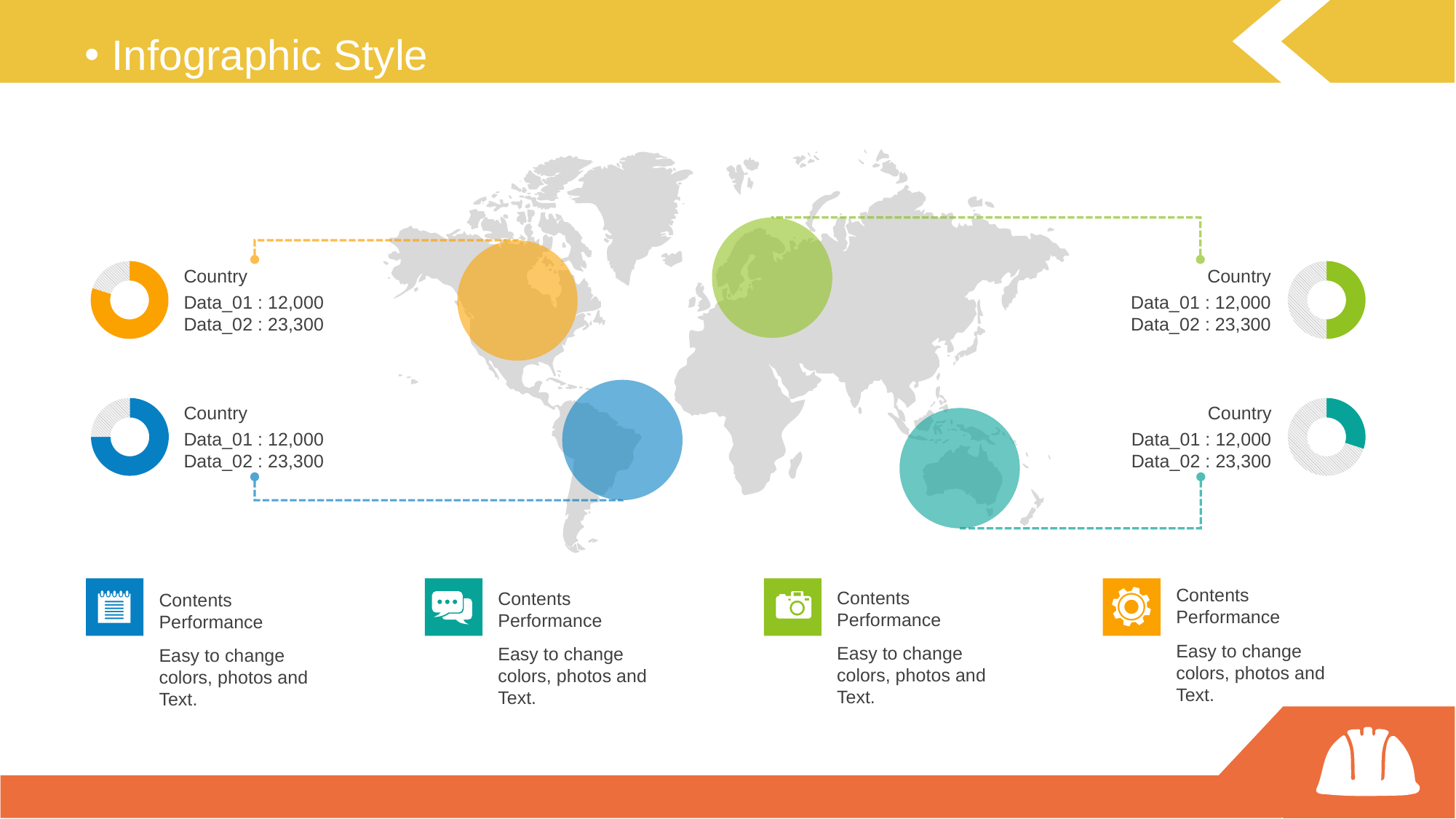
How many doughnut charts are on the slide? 4 For the top-left (orange) doughnut chart, what is the value of Data_02? 23,300 For the top-right (green) doughnut chart, what is the value of Data_01? 12,000 For the bottom-left (blue) doughnut chart, what is the difference between Data_02 and Data_01? 11,300 For the bottom-left (blue) doughnut chart, what is the value of Data_02? 23,300 For the top-left (orange) doughnut chart, what is the value of Data_01? 12,000 For the top-left (orange) doughnut chart, what is the difference between Data_02 and Data_01? 11,300 What kind of chart is shown next to each 'Country' label on the slide? doughnut chart For the bottom-right (teal) doughnut chart, which is larger, Data_01 or Data_02? Data_02 What colour is the doughnut chart in the bottom-left position of the slide? blue What colour is the doughnut chart in the top-right position of the slide? green